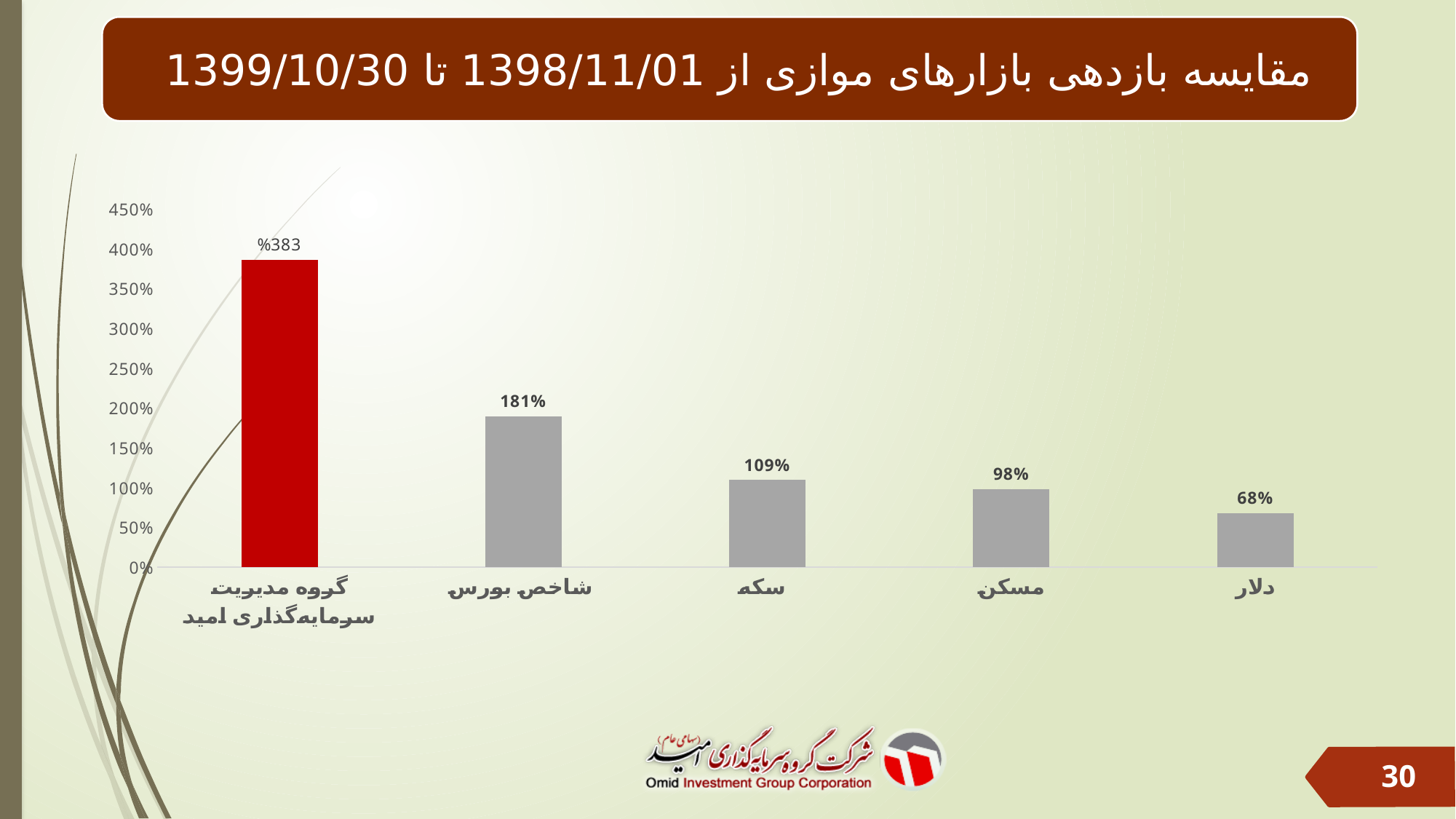
How many categories (bars) are shown in the chart? 5 What is the value shown for گروه مدیریت سرمایه‌گذاری امید? 383% What is the value shown for شاخص بورس? 181% Which bar is coloured red rather than grey? گروه مدیریت سرمایه‌گذاری امید Which category has the highest value? گروه مدیریت سرمایه‌گذاری امید Which is larger, the value for مسکن or the value for دلار? مسکن What is the value shown for سکه? 109% What type of chart is shown on the slide? bar chart What is the value shown for مسکن? 98% Which category has the lowest value? دلار What is the difference between the values for شاخص بورس and سکه? 72% What is the value shown for دلار? 68%